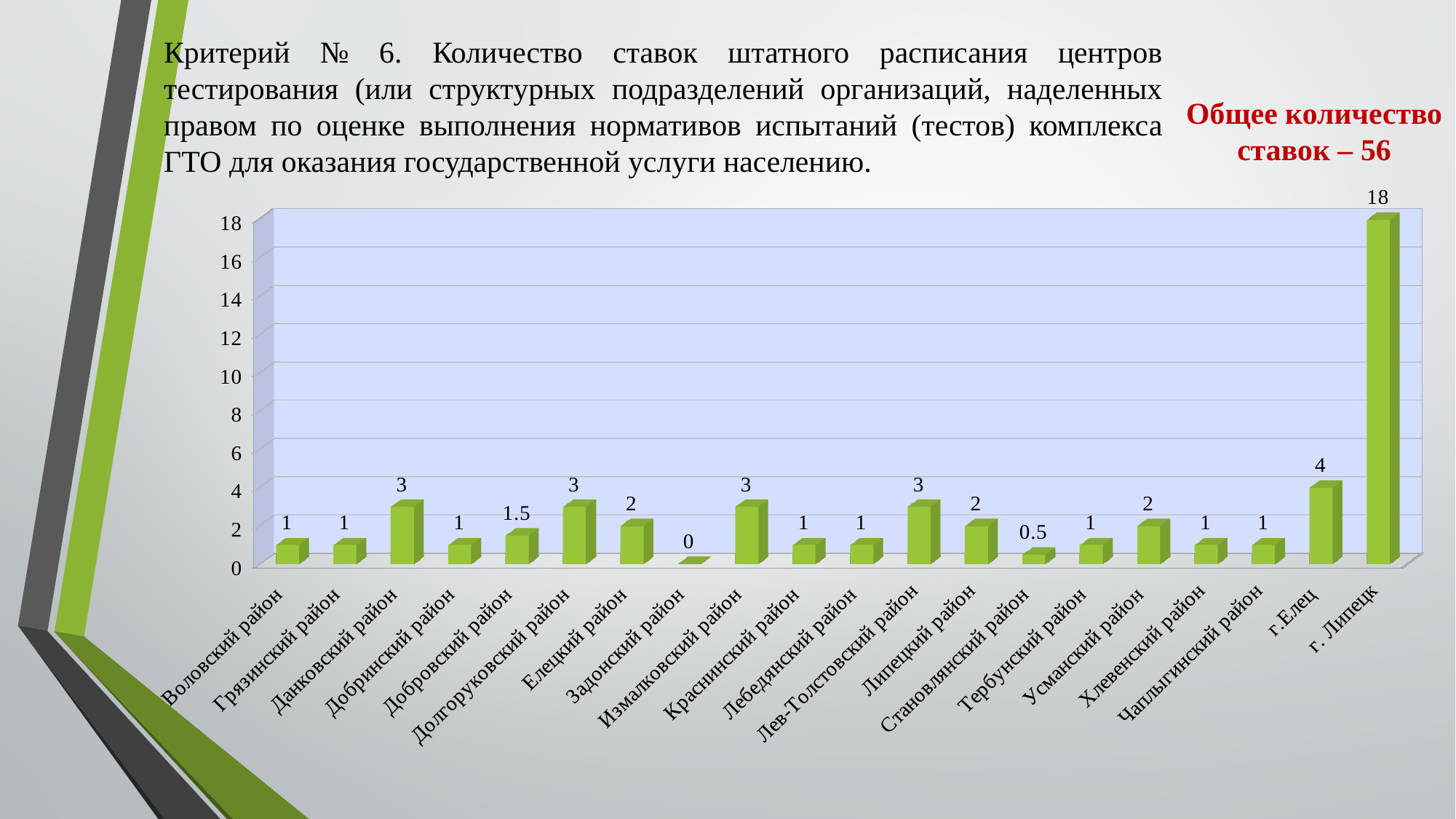
What value is shown for Становлянский район? 0.5 What value is shown for Добровский район? 1.5 What kind of chart is shown on the slide? bar chart How many categories are shown on the x axis? 20 What value is shown for г.Елец? 4 What is the difference between the values for г. Липецк and г.Елец? 14 Which is larger, the value for Данковский район or the value for Елецкий район? Данковский район What value is shown for г. Липецк? 18 Which category has the lowest value? Задонский район What total number of ставок is stated in red text on the slide? 56 Which category has the highest value? г. Липецк Is the value for г. Липецк greater or less than 10? greater